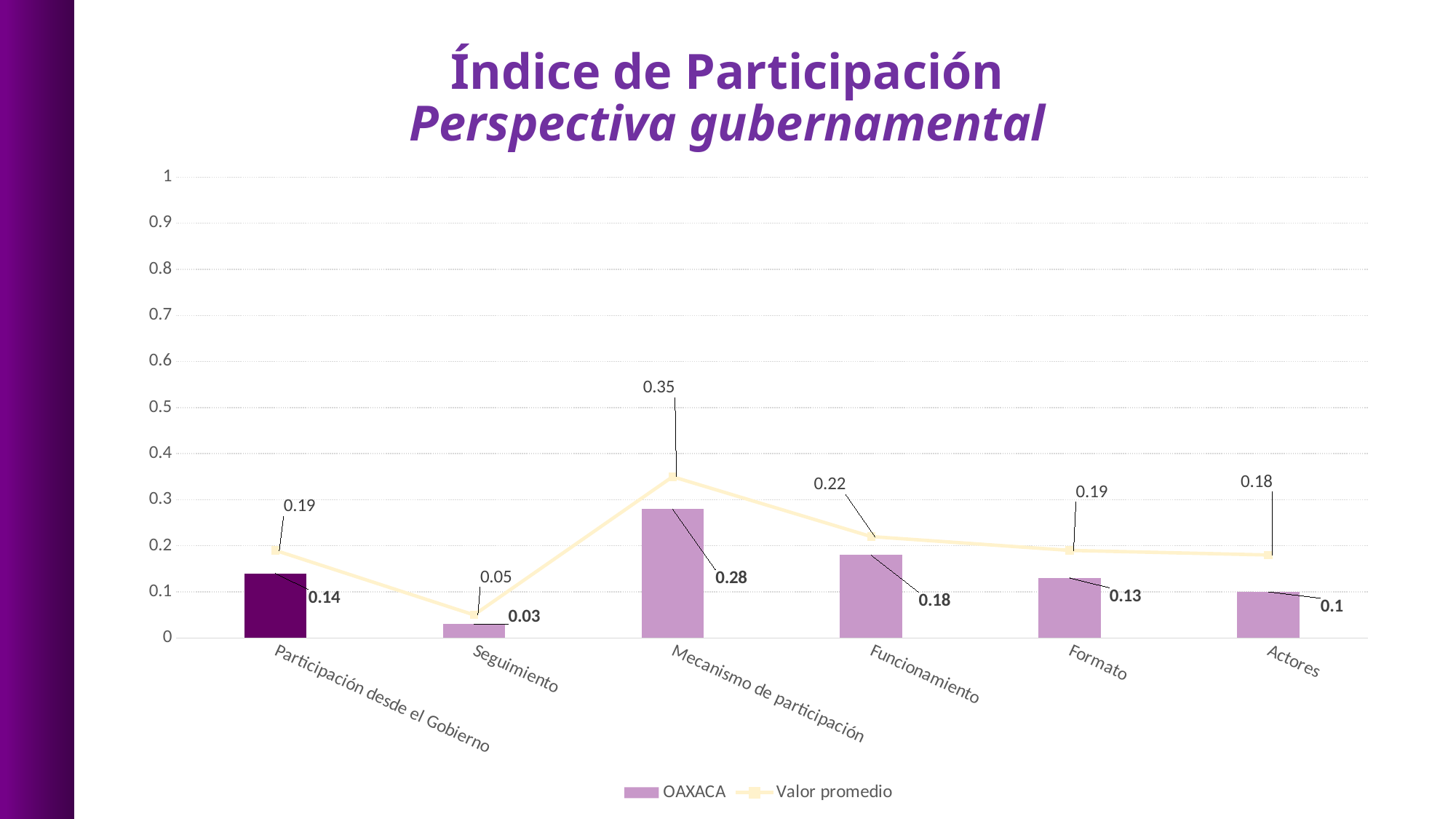
Which category has the highest OAXACA value? Mecanismo de participación What is the OAXACA value for Mecanismo de participación? 0.28 What is the OAXACA value for Actores? 0.1 Which is larger for Formato: the OAXACA value or the Valor promedio value? Valor promedio How many series does the legend list? 2 How many categories are shown on the x axis? 6 What is the title of the chart? Índice de Participación Perspectiva gubernamental What is the Valor promedio value for Seguimiento? 0.05 Is the OAXACA value for Funcionamiento greater or less than 0.2? less What is the Valor promedio value for Funcionamiento? 0.22 Which category has the lowest Valor promedio value? Seguimiento What is the difference between the Valor promedio and OAXACA values for Participación desde el Gobierno? 0.05